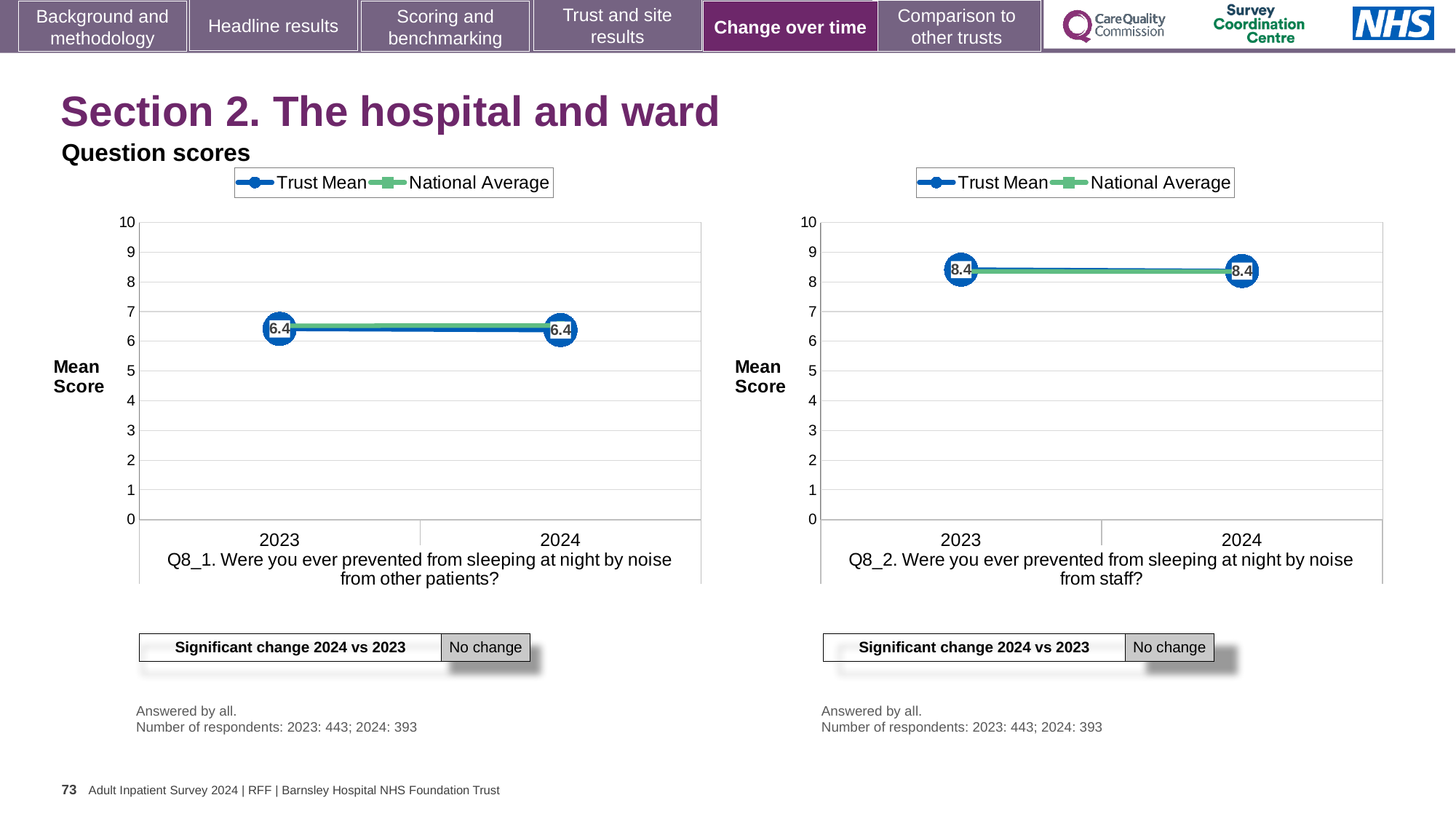
On the left chart (Q8_1), what is the difference between the Trust Mean scores for 2024 and 2023? 0 On the left chart (Q8_1), is the National Average value for 2024 greater or less than 6? greater On the right chart (Q8_2), what is the Trust Mean score for 2024? 8.4 On the right chart (Q8_2), what is the Trust Mean score for 2023? 8.4 On the right chart (Q8_2), does the Trust Mean rise, fall or stay the same from 2023 to 2024? stays the same How many series does the legend of the left chart (Q8_1) list? 2 On the left chart (Q8_1), what is the Trust Mean score for 2024? 6.4 On the right chart (Q8_2), is the National Average value for 2023 greater or less than 8? greater On the left chart (Q8_1), what is the Trust Mean score for 2023? 6.4 What is the label of the y axis on the right chart (Q8_2)? Mean Score How many years are plotted on the x axis of the right chart (Q8_2)? 2 What kind of chart is the left chart (Q8_1)? line chart